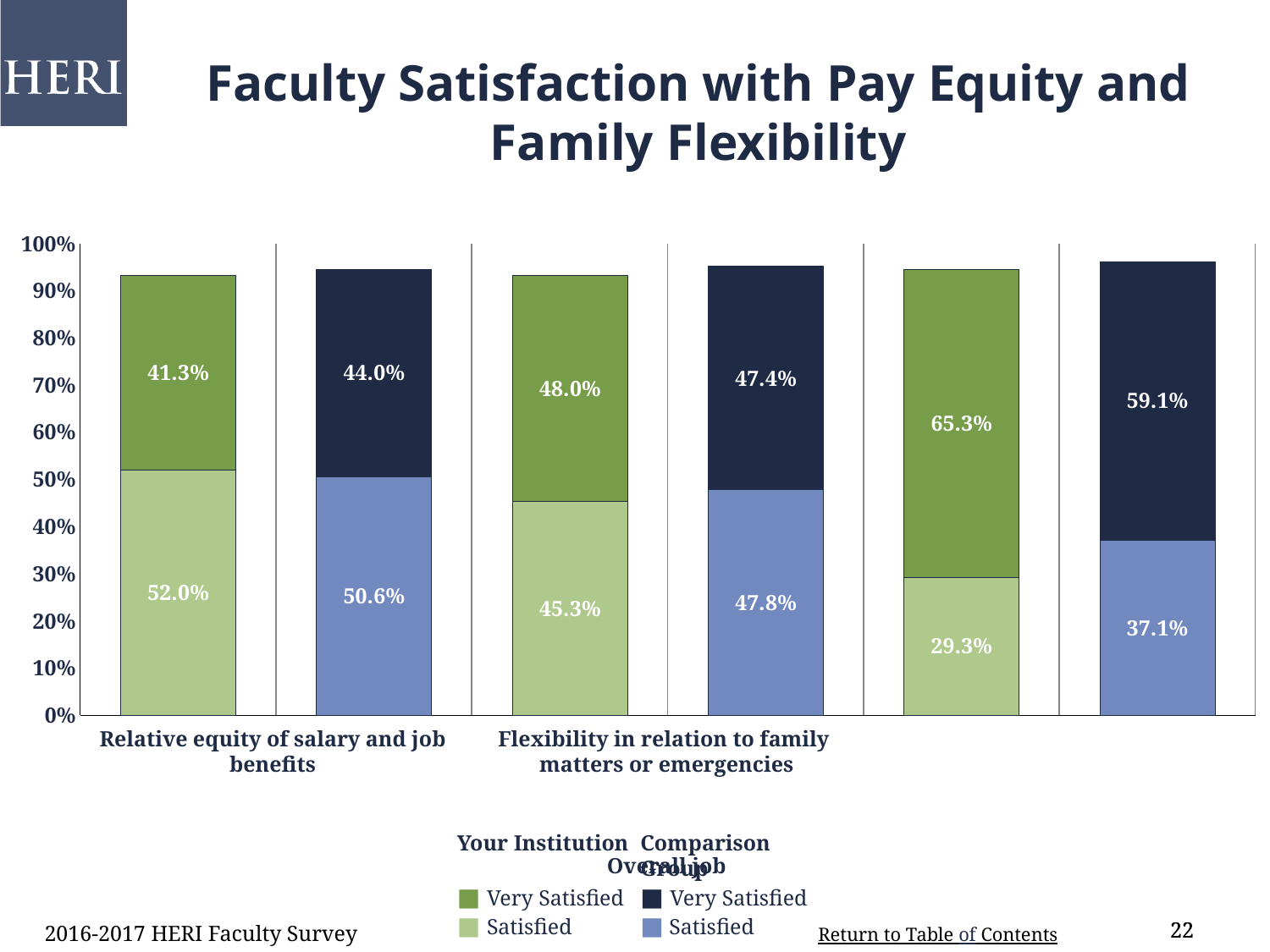
What is the Very Satisfied value for the Comparison Group on Flexibility in relation to family matters or emergencies? 47.4% For Relative equity of salary and job benefits, which has the larger Satisfied value: Your Institution or the Comparison Group? Your Institution What colour represents Very Satisfied for Your Institution? Green In the rightmost pair of bars, what is the Satisfied value for the Comparison Group? 37.1% What percentage of Your Institution faculty are Very Satisfied with Relative equity of salary and job benefits? 41.3% What is the combined Satisfied plus Very Satisfied total for Your Institution on Relative equity of salary and job benefits? 93.3% What kind of chart is shown on the slide? Stacked bar chart What percentage of Comparison Group faculty are Satisfied with Flexibility in relation to family matters or emergencies? 47.8% What is the combined Satisfied plus Very Satisfied total for the Comparison Group on Flexibility in relation to family matters or emergencies? 95.2% What is the Satisfied value for Your Institution on Relative equity of salary and job benefits? 52.0% For Relative equity of salary and job benefits, how much higher is the Comparison Group's Very Satisfied value than Your Institution's? 2.7 percentage points How many entries does the legend list? 4